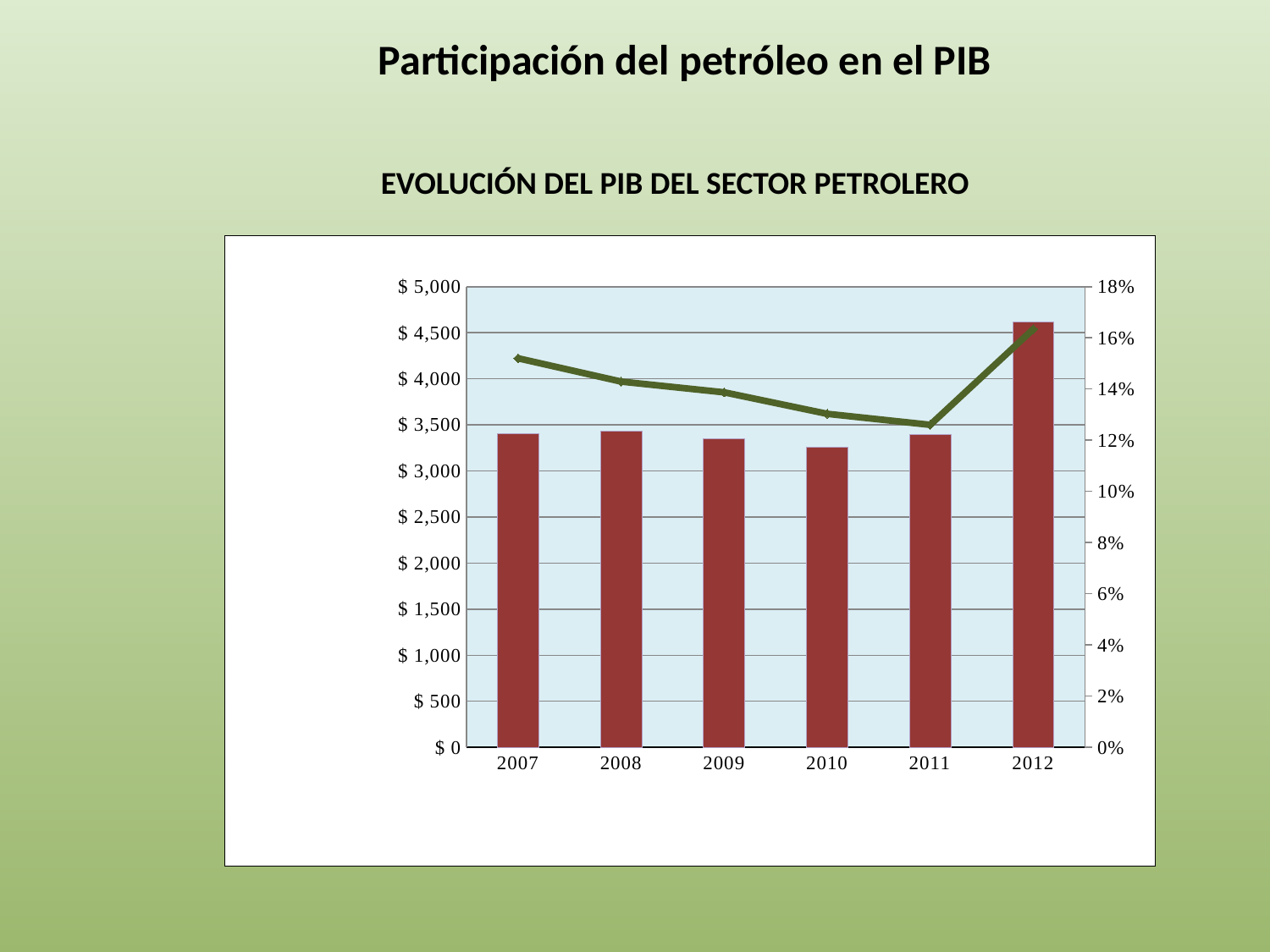
What is the title of the chart? EVOLUCIÓN DEL PIB DEL SECTOR PETROLERO Which year has the shortest bar in the chart? 2010 Is the bar value for 2007 greater or less than $ 3,000? greater Is the line value for 2012 greater or less than 16%? greater Which year has the tallest bar in the chart? 2012 Is the bar value for 2012 greater or less than $ 4,000? greater How many years are shown on the x axis of the chart? 6 What kind of chart is shown on the slide? A combined bar and line chart Does the line rise or fall from 2007 to 2011? fall Which year has the larger bar value, 2011 or 2012? 2012